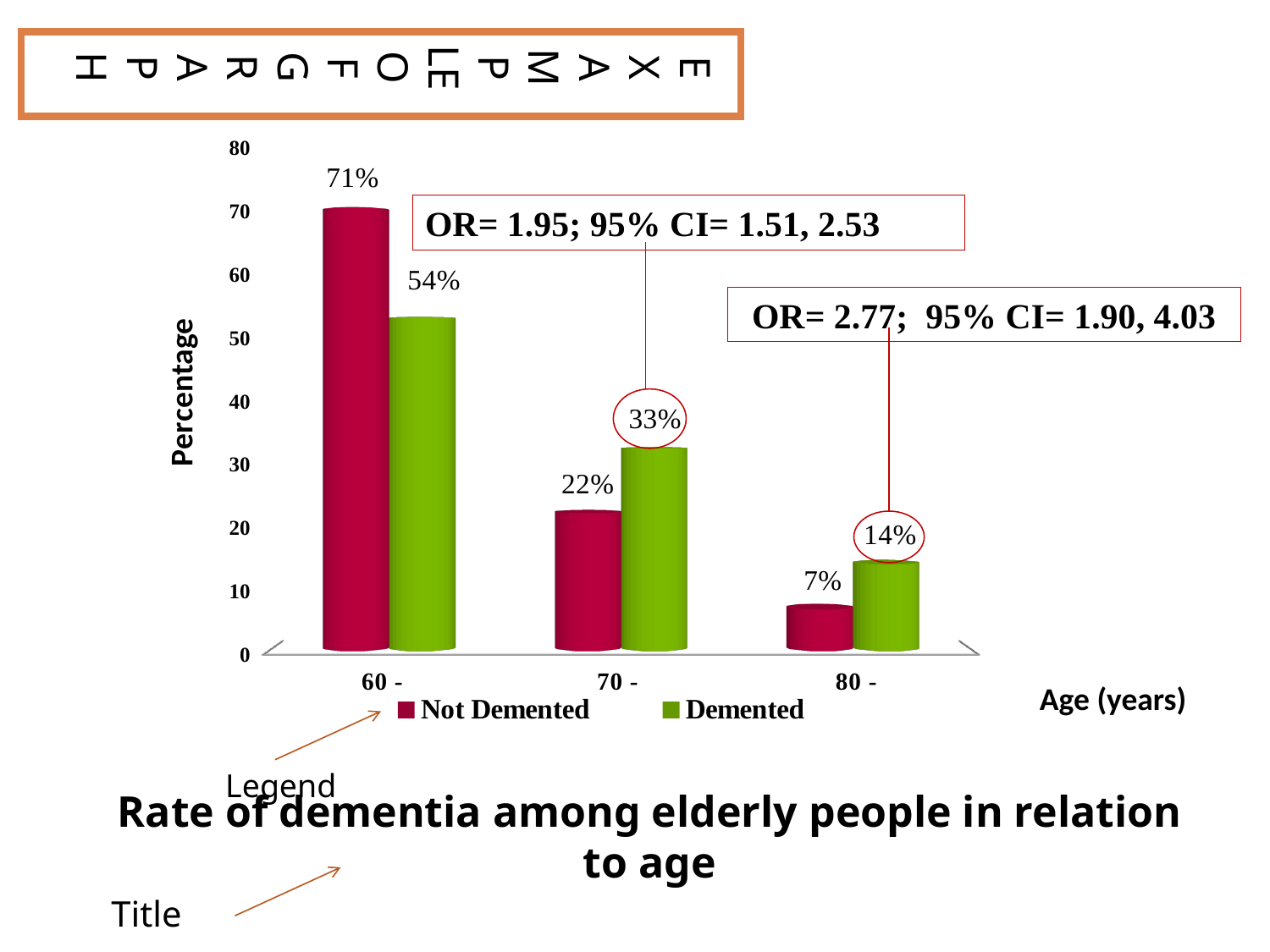
What is the value for Demented in the 70 - age group? 33% How many series does the legend list? 2 Which age group has the highest Demented value? 60 - Is the Demented value for the 80 - age group greater or less than 20? less Which age group has the lowest Not Demented value? 80 - What kind of chart is shown? bar chart What is the difference between the Not Demented and Demented values in the 60 - age group? 17% Do the Not Demented values rise or fall as age increases along the x axis? fall Which is larger in the 70 - age group, Not Demented or Demented? Demented How many age groups are shown on the x axis? 3 What is the value for Not Demented in the 80 - age group? 7% What is the value for Not Demented in the 60 - age group? 71%